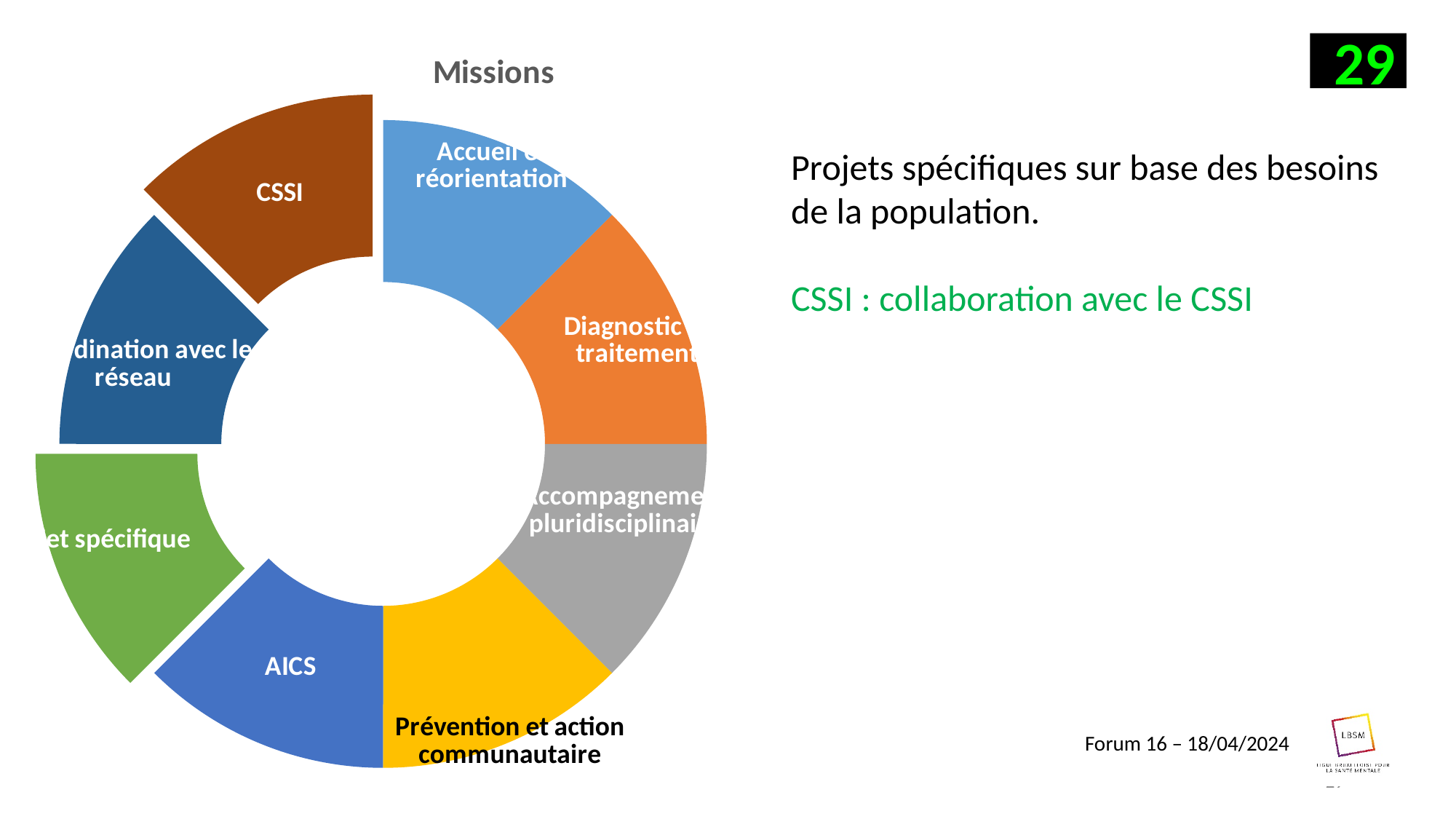
Which segment of the doughnut chart is labelled AICS? The blue segment at the bottom left Which segment of the doughnut chart is coloured yellow? Prévention et action communautaire What kind of chart is shown on the slide? Doughnut chart Are any numeric data labels printed on the doughnut chart segments? No What is the title of the chart on the slide? Missions How many segments does the doughnut chart contain? 8 What colour is the CSSI segment of the doughnut chart? Brown